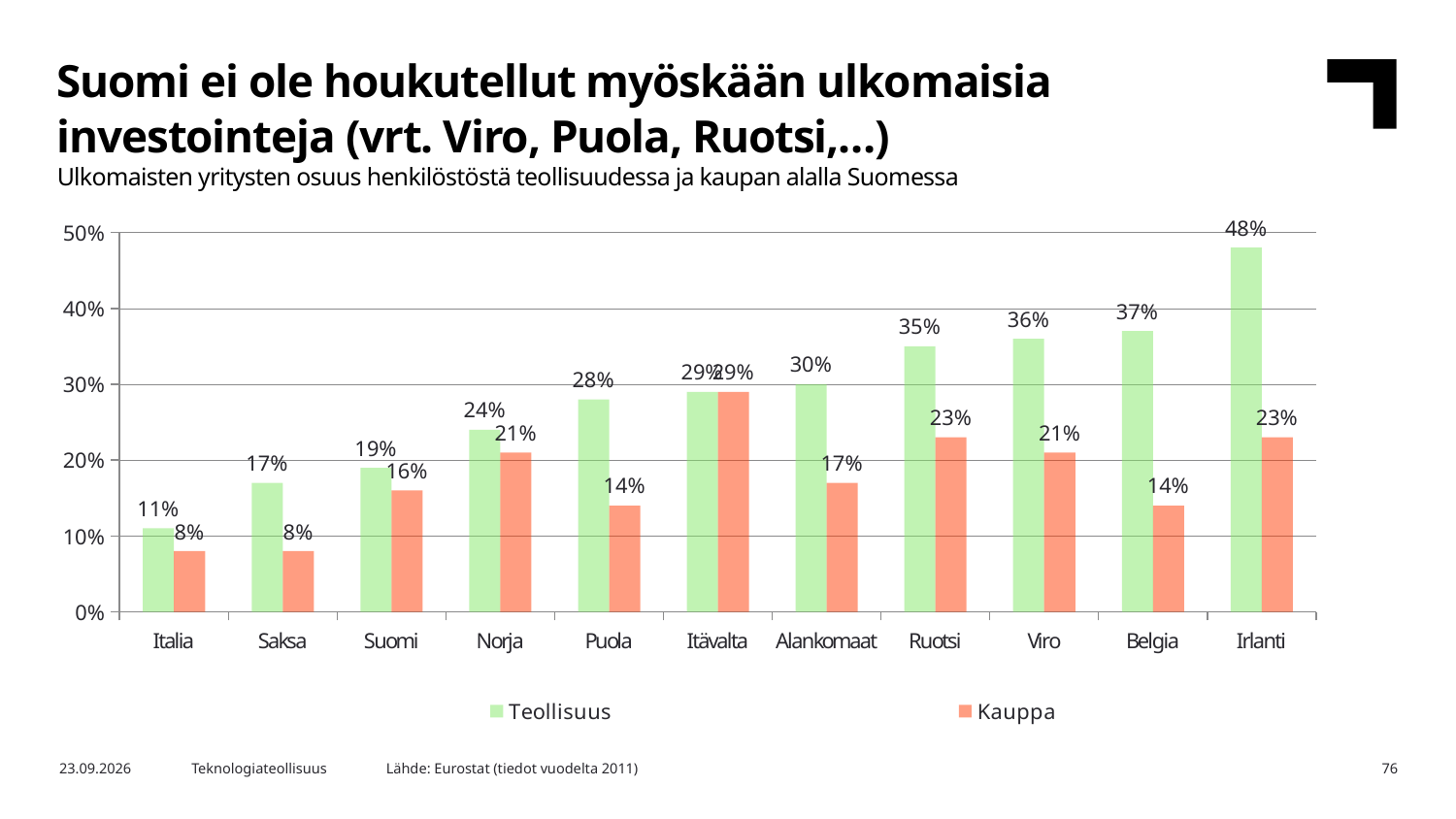
Is the Teollisuus value for Belgia greater or less than 30%? greater Do the Teollisuus values rise or fall from Italia to Irlanti along the x axis? Rise What is the Teollisuus value for Suomi? 19% How many series does the legend list? 2 Which colour represents the Kauppa series in the legend? Orange How many countries are shown on the x axis? 11 What is the Kauppa value for Viro? 21% What kind of chart is shown on the slide? Bar chart Which country has the highest Teollisuus value? Irlanti Which is larger, the Kauppa value for Ruotsi or the Kauppa value for Alankomaat? Ruotsi What is the difference between the Teollisuus and Kauppa values for Puola? 14% Which country has the lowest Teollisuus value? Italia